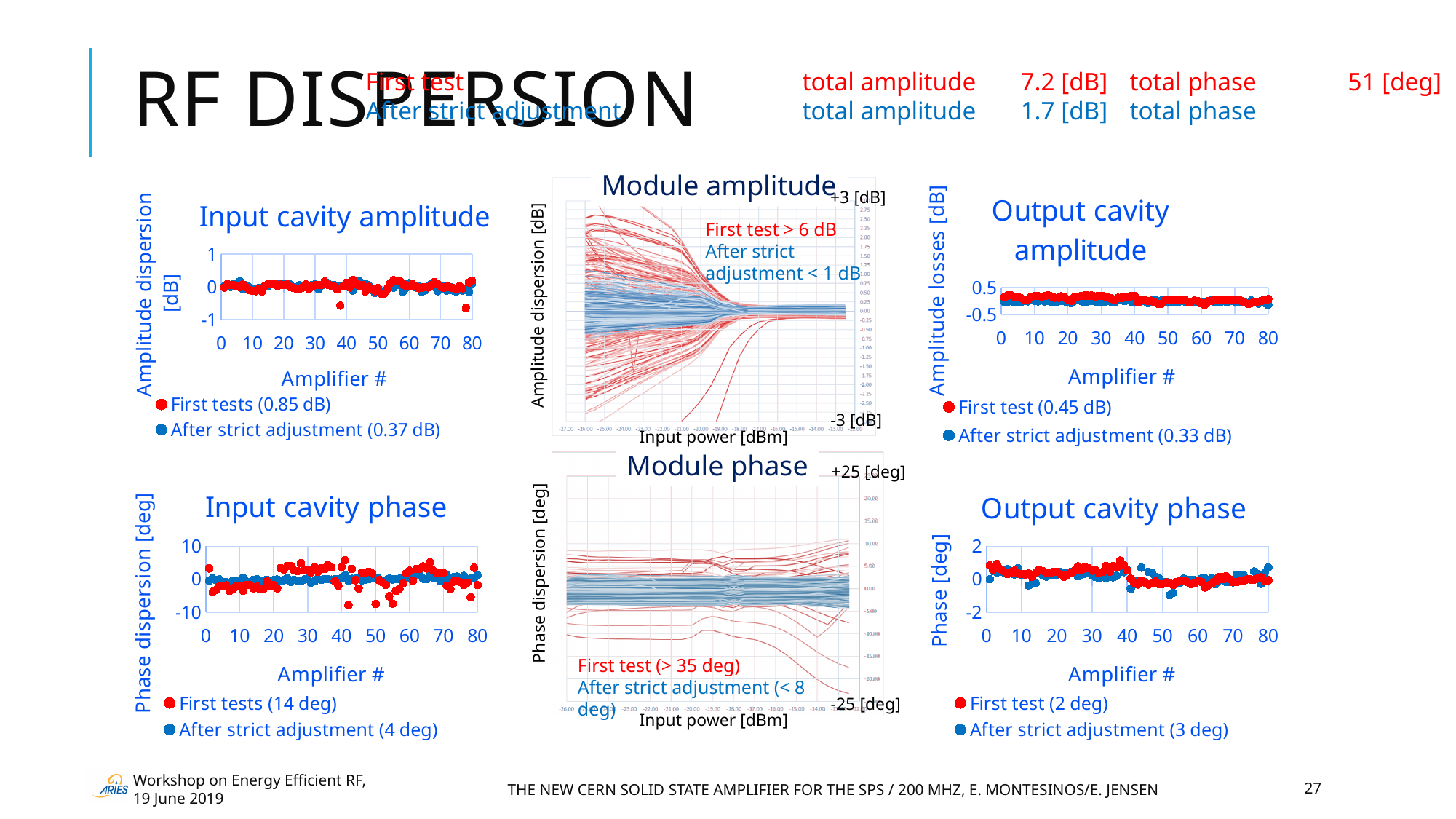
What is the x-axis label of the 'Module amplitude' chart? Input power [dBm] How many series does the legend of the 'Input cavity amplitude' chart list? 2 In the 'Input cavity amplitude' chart, what dispersion value is given in the legend for the 'After strict adjustment' series? 0.37 dB In the 'Output cavity amplitude' chart, what value is given in the legend for the 'First test' series? 0.45 dB What is the x-axis label of the 'Output cavity phase' chart? Amplifier # In the 'Input cavity amplitude' chart, what dispersion value is given in the legend for the 'First tests' series? 0.85 dB In the 'Output cavity phase' chart, are the 'First test' points for amplifiers 0 to 40 greater or less than 0 deg? greater In the 'Input cavity phase' chart, what is the difference between the legend values for 'First tests' and 'After strict adjustment'? 10 deg In the 'Input cavity phase' chart, what value is given in the legend for the 'After strict adjustment' series? 4 deg In the 'Input cavity phase' chart, are the 'First tests' points for amplifiers around 20 to 40 mostly greater or less than 0 deg? greater In the 'Output cavity phase' chart, which legend series has the larger value, 'First test' or 'After strict adjustment'? After strict adjustment In the 'Input cavity phase' chart, what value is given in the legend for the 'First tests' series? 14 deg